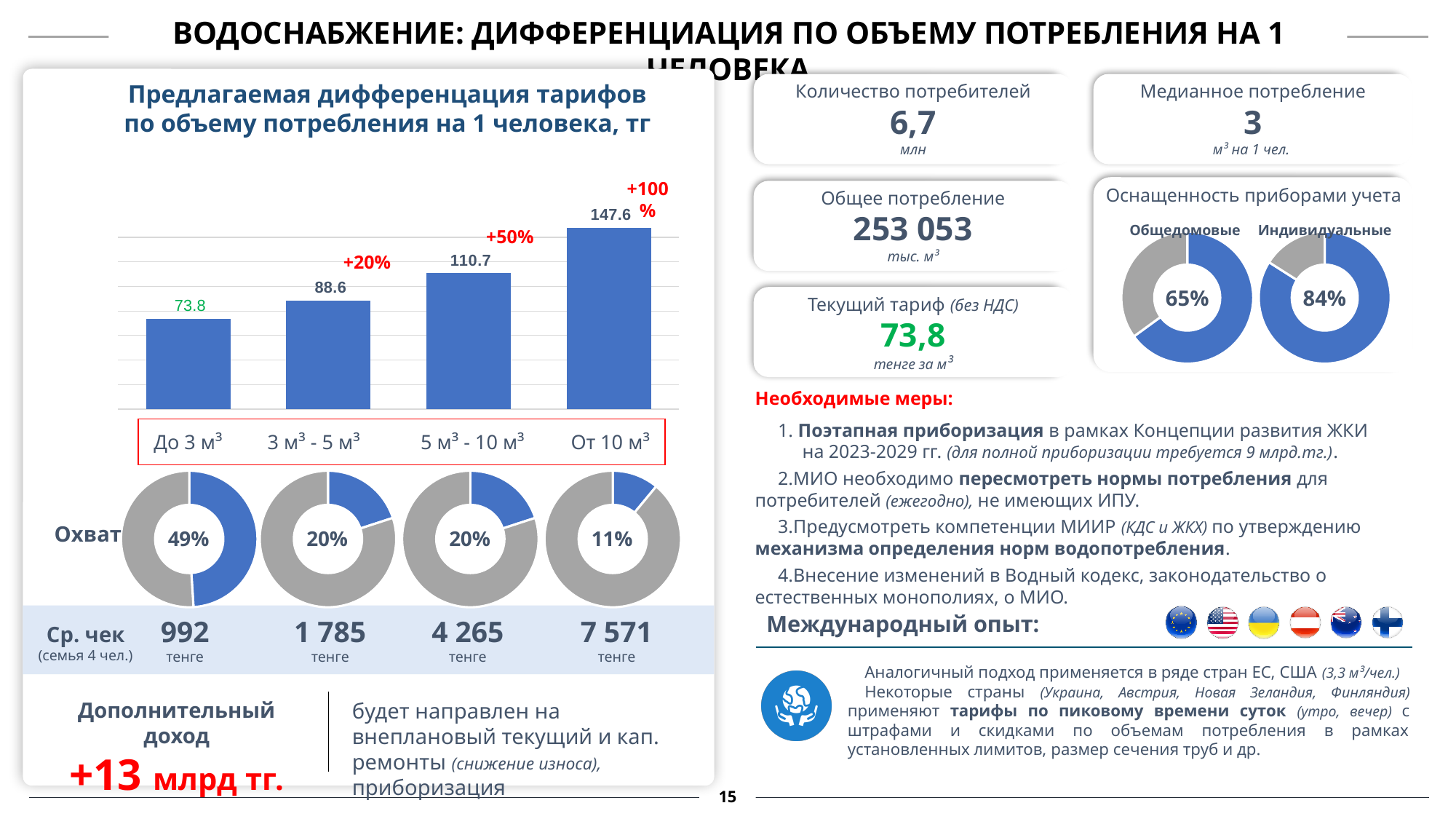
In the bar chart 'Предлагаемая дифференцация тарифов по объему потребления на 1 человека, тг', what is the value for '5 м³ - 10 м³'? 110.7 In the 'Оснащенность приборами учета' donut charts, what share is shown for 'Индивидуальные'? 84% What kind of chart is 'Предлагаемая дифференцация тарифов по объему потребления на 1 человека, тг'? Bar chart In the bar chart 'Предлагаемая дифференцация тарифов по объему потребления на 1 человека, тг', what is the value for 'До 3 м³'? 73.8 In the bar chart 'Предлагаемая дифференцация тарифов по объему потребления на 1 человека, тг', which category has the lowest value? До 3 м³ In the bar chart 'Предлагаемая дифференцация тарифов по объему потребления на 1 человека, тг', do the values rise or fall from left to right? Rise How many categories are shown in the bar chart 'Предлагаемая дифференцация тарифов по объему потребления на 1 человека, тг'? 4 In the 'Охват' donut charts, what share is shown for the 'До 3 м³' category? 49% In the bar chart 'Предлагаемая дифференцация тарифов по объему потребления на 1 человека, тг', what is the difference between the values for 'От 10 м³' and 'До 3 м³'? 73.8 In the bar chart 'Предлагаемая дифференцация тарифов по объему потребления на 1 человека, тг', which is larger: the value for '3 м³ - 5 м³' or for '5 м³ - 10 м³'? 5 м³ - 10 м³ In the bar chart 'Предлагаемая дифференцация тарифов по объему потребления на 1 человека, тг', which category has the highest value? От 10 м³ In the bar chart 'Предлагаемая дифференцация тарифов по объему потребления на 1 человека, тг', what is the value for 'От 10 м³'? 147.6